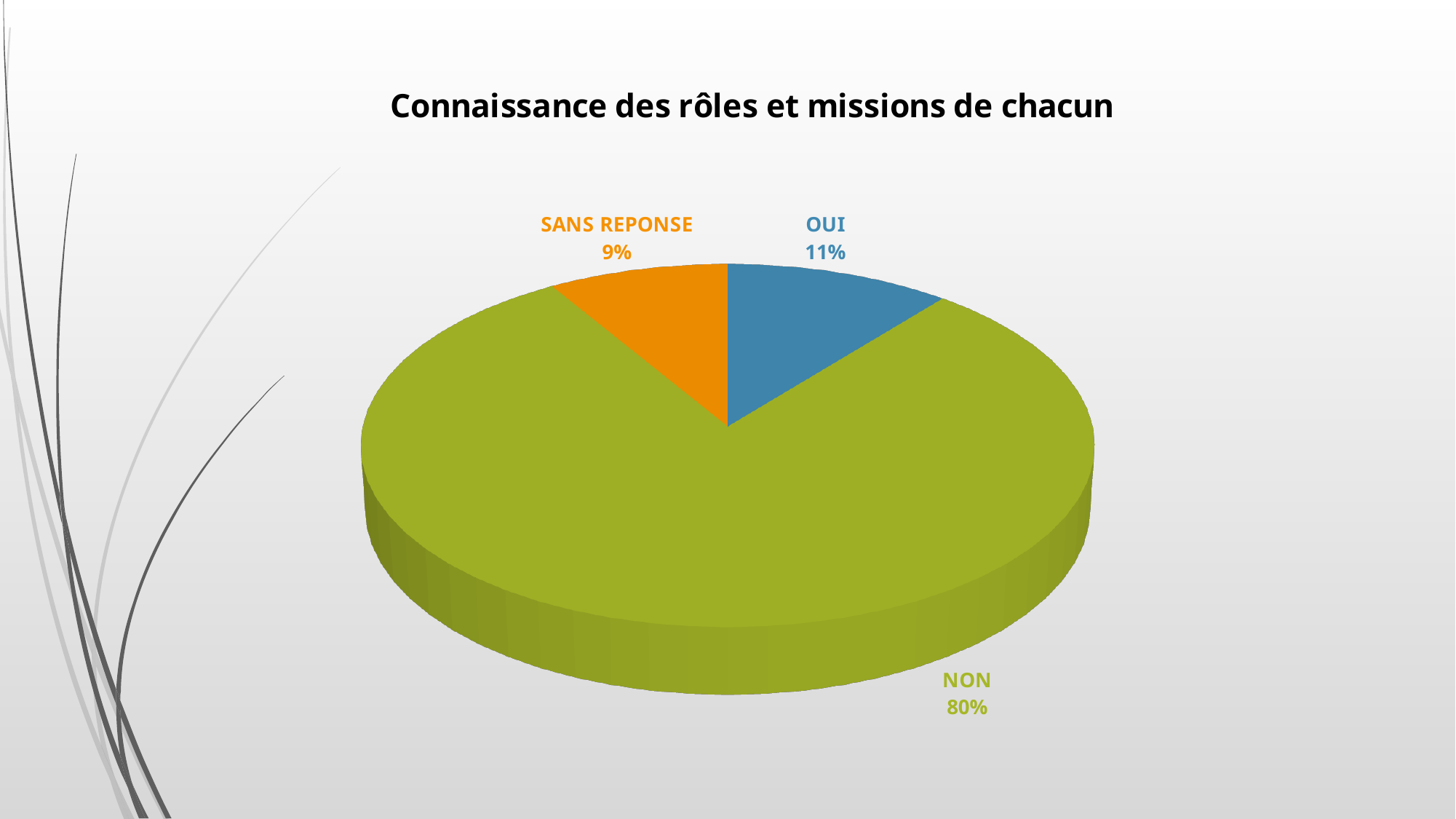
What is the title of the chart? Connaissance des rôles et missions de chacun What is the difference in percentage points between NON and OUI? 69 Which is larger, the share for OUI or the share for SANS REPONSE? OUI How many slices does the pie chart have? 3 What percentage is shown for OUI? 11% What percentage is shown for NON? 80% Which category has the largest share of the pie? NON Which category has the smallest share of the pie? SANS REPONSE What percentage is shown for SANS REPONSE? 9% What kind of chart is shown on the slide? Pie chart What colour is the NON slice? Green What is the difference in percentage points between OUI and SANS REPONSE? 2